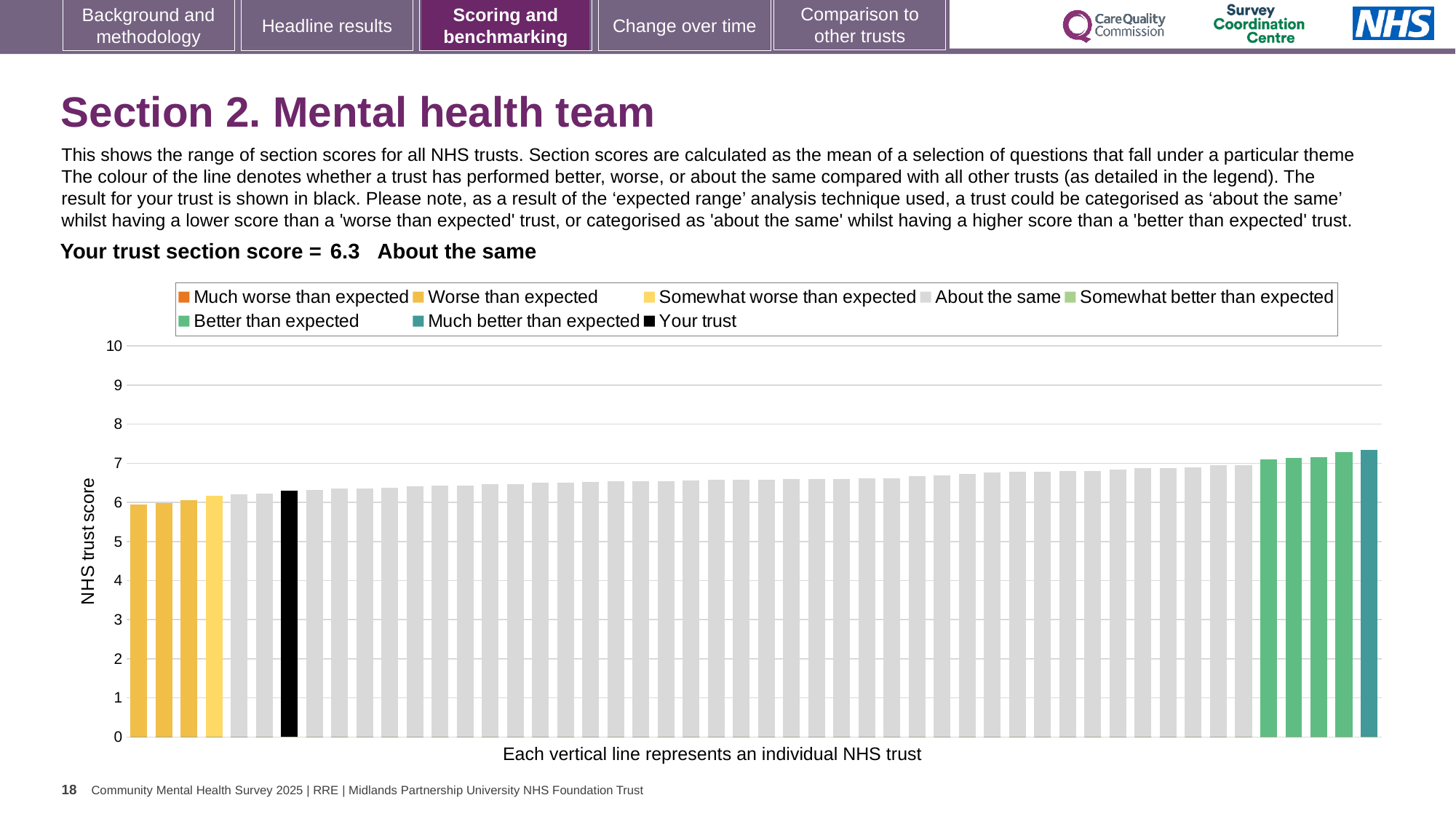
What is the label on the vertical axis of the chart? NHS trust score Do the bar values rise or fall from left to right along the x axis? Rise What is the section score for your trust shown on the slide? 6.3 Is the value of the black 'Your trust' bar greater or less than 6? greater How many bars are coloured as 'Much better than expected' (teal)? 1 What kind of chart is shown on the slide? Bar chart Is the value of the shortest bar greater or less than 5? greater How many bars are coloured as 'Better than expected' (green)? 4 Which category is your trust's section score placed in? About the same How many entries does the chart legend list? 8 What is the highest value shown on the vertical axis? 10 Is the value of the tallest bar greater or less than 7? greater